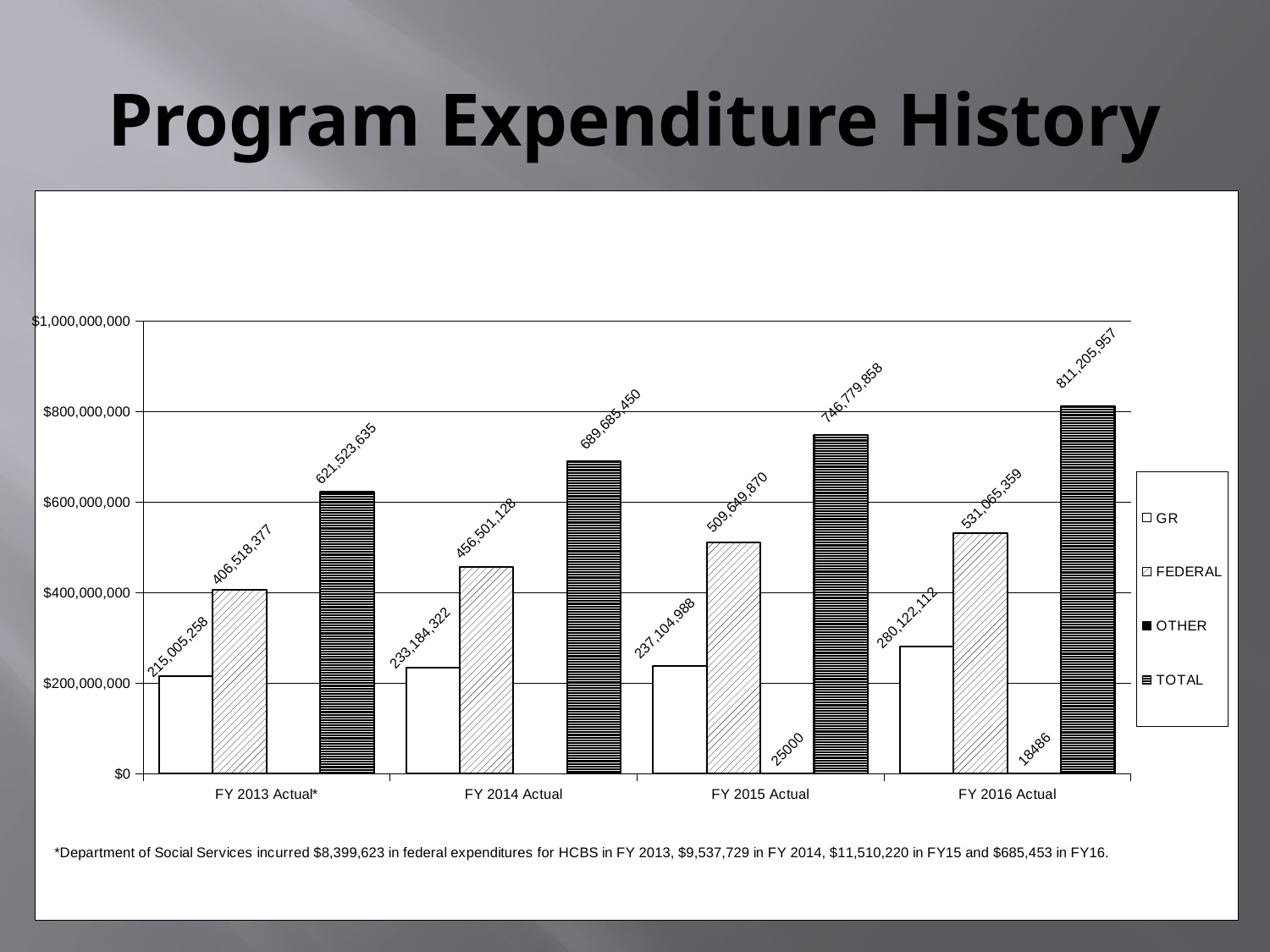
Do the TOTAL values rise or fall from FY 2013 Actual* to FY 2016 Actual? Rise Which fiscal year has the lowest GR value? FY 2013 Actual* How many fiscal year categories are shown on the x axis? 4 What is the OTHER value for FY 2015 Actual? 25000 How many series does the legend list? 4 What is the GR value for FY 2013 Actual*? 215,005,258 What is the TOTAL value for FY 2016 Actual? 811,205,957 Which fiscal year has the highest TOTAL value? FY 2016 Actual What is the FEDERAL value for FY 2015 Actual? 509,649,870 What is the difference between the TOTAL values for FY 2014 Actual and FY 2013 Actual*? 68,161,815 Which is larger, the FEDERAL value for FY 2014 Actual or the FEDERAL value for FY 2016 Actual? FY 2016 Actual What kind of chart is shown on the slide? Bar chart